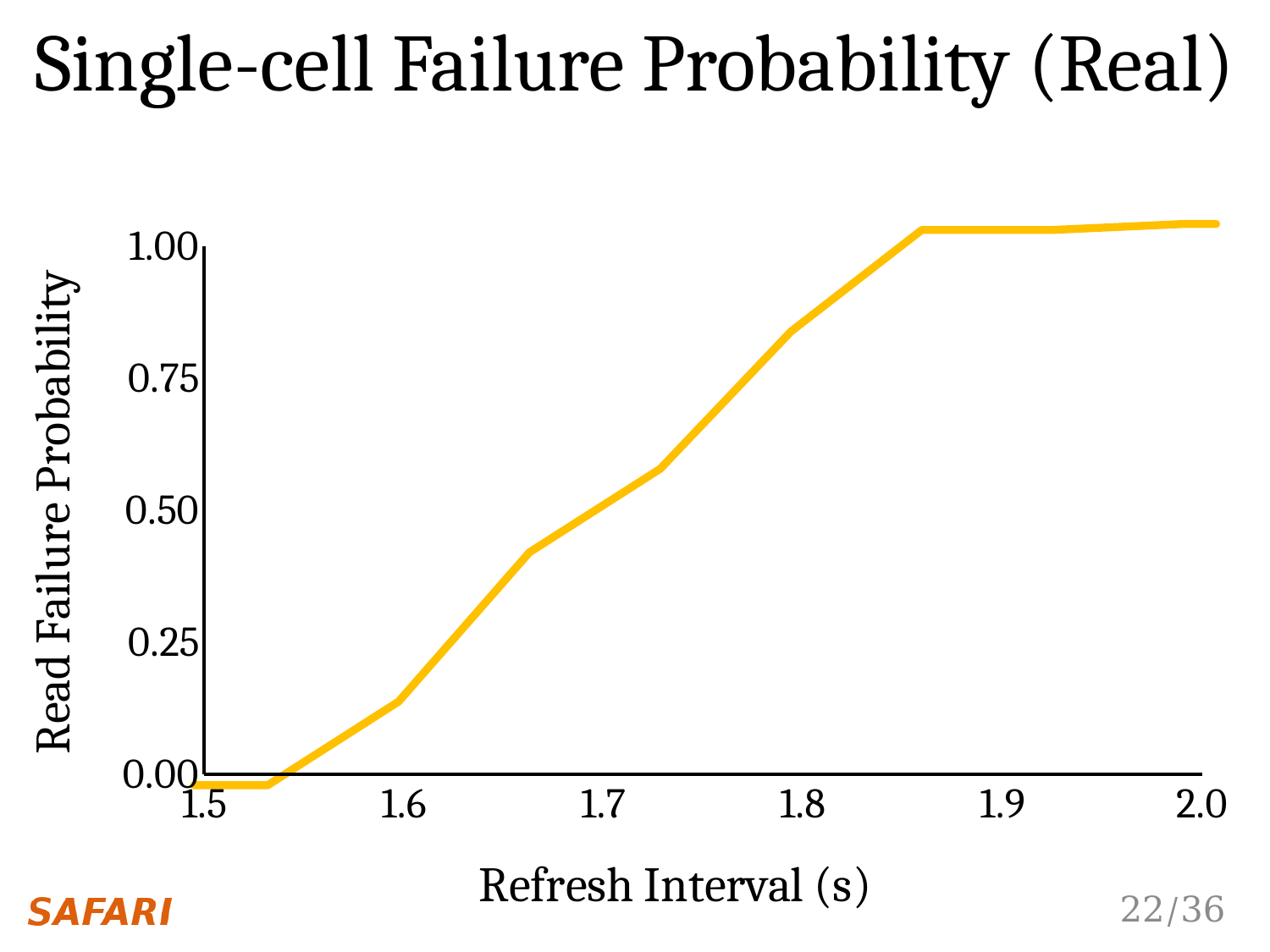
What is the highest tick value shown on the y axis? 1.00 What kind of chart is shown on the slide? line chart Does the read failure probability rise or fall as the refresh interval increases from 1.5 s to 2.0 s? rise Is the read failure probability at a refresh interval of 1.8 s greater or less than 0.75? greater Is the read failure probability at a refresh interval of 1.6 s greater or less than 0.25? less Is the read failure probability at a refresh interval of 1.7 s greater or less than 0.25? greater Which has the lower read failure probability: a refresh interval of 1.7 s or 1.9 s? 1.7 s What is the title of the chart? Single-cell Failure Probability (Real) Which has the higher read failure probability: a refresh interval of 1.6 s or 1.8 s? 1.8 s What is the label of the x axis? Refresh Interval (s)